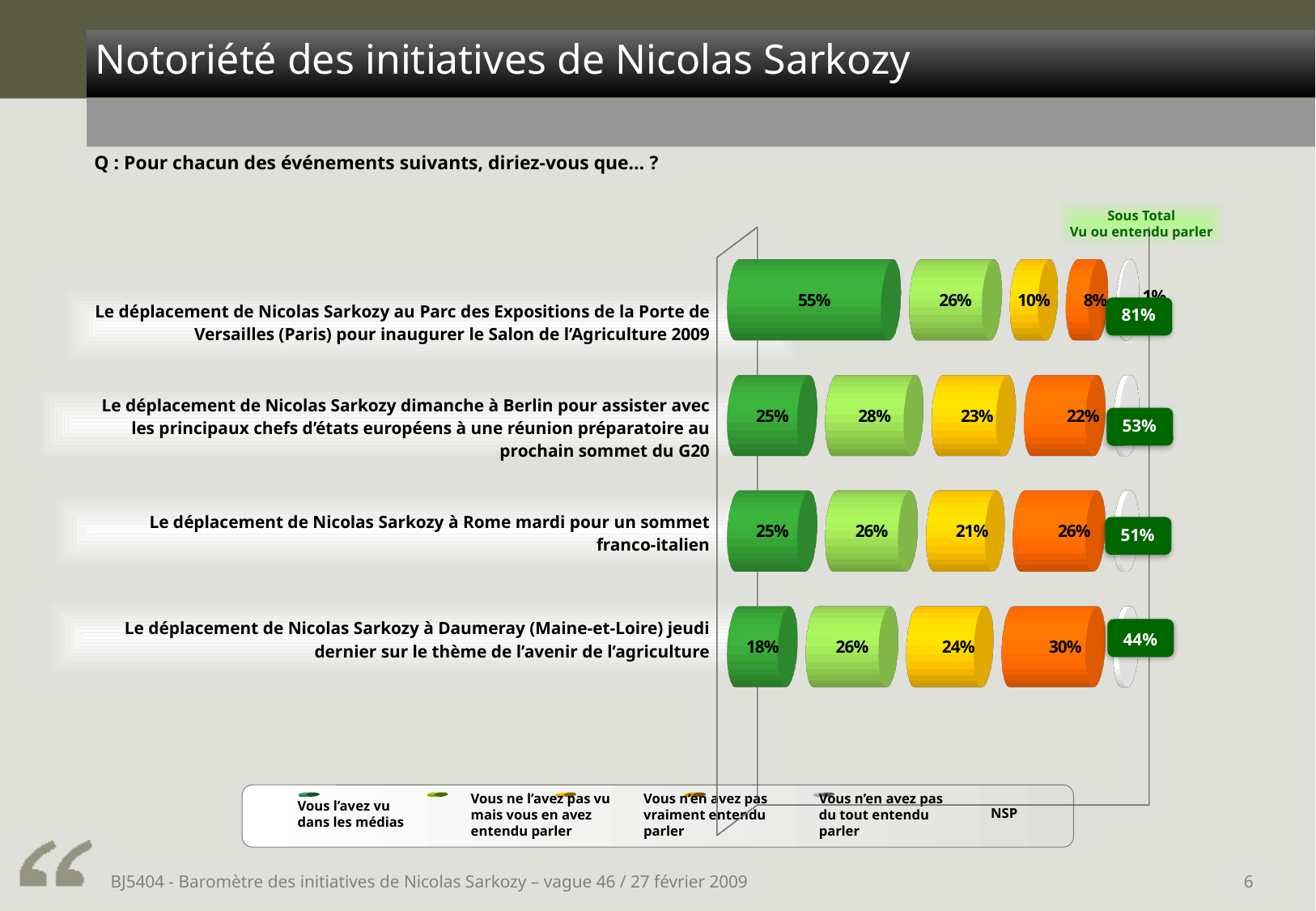
Which event has the lowest 'Sous Total Vu ou entendu parler'? Le déplacement de Nicolas Sarkozy à Daumeray (Maine-et-Loire) jeudi dernier sur le thème de l'avenir de l'agriculture What kind of chart is shown on the slide? Stacked bar chart What percentage answered 'Vous n'en avez pas du tout entendu parler' for the trip to Daumeray (Maine-et-Loire)? 30% What percentage answered 'Vous n'en avez pas vraiment entendu parler' for the trip to Berlin? 23% What is the NSP value shown for the Salon de l'Agriculture trip? 1% Which event has the highest 'Sous Total Vu ou entendu parler'? Le déplacement de Nicolas Sarkozy au Parc des Expositions de la Porte de Versailles (Paris) pour inaugurer le Salon de l'Agriculture 2009 How many series does the legend list? 5 What percentage of respondents said 'Vous l'avez vu dans les médias' for the trip to the Salon de l'Agriculture 2009 at the Porte de Versailles? 55% For the trip to Rome, which is larger: 'Vous l'avez vu dans les médias' or 'Vous n'en avez pas du tout entendu parler'? Vous n'en avez pas du tout entendu parler What is the 'Sous Total Vu ou entendu parler' value for the trip to Berlin for the G20 preparatory meeting? 53% How many events (categories) are plotted in the chart? 4 What is the difference between the 'Sous Total' for the Salon de l'Agriculture trip and the 'Sous Total' for the Rome trip? 30 percentage points